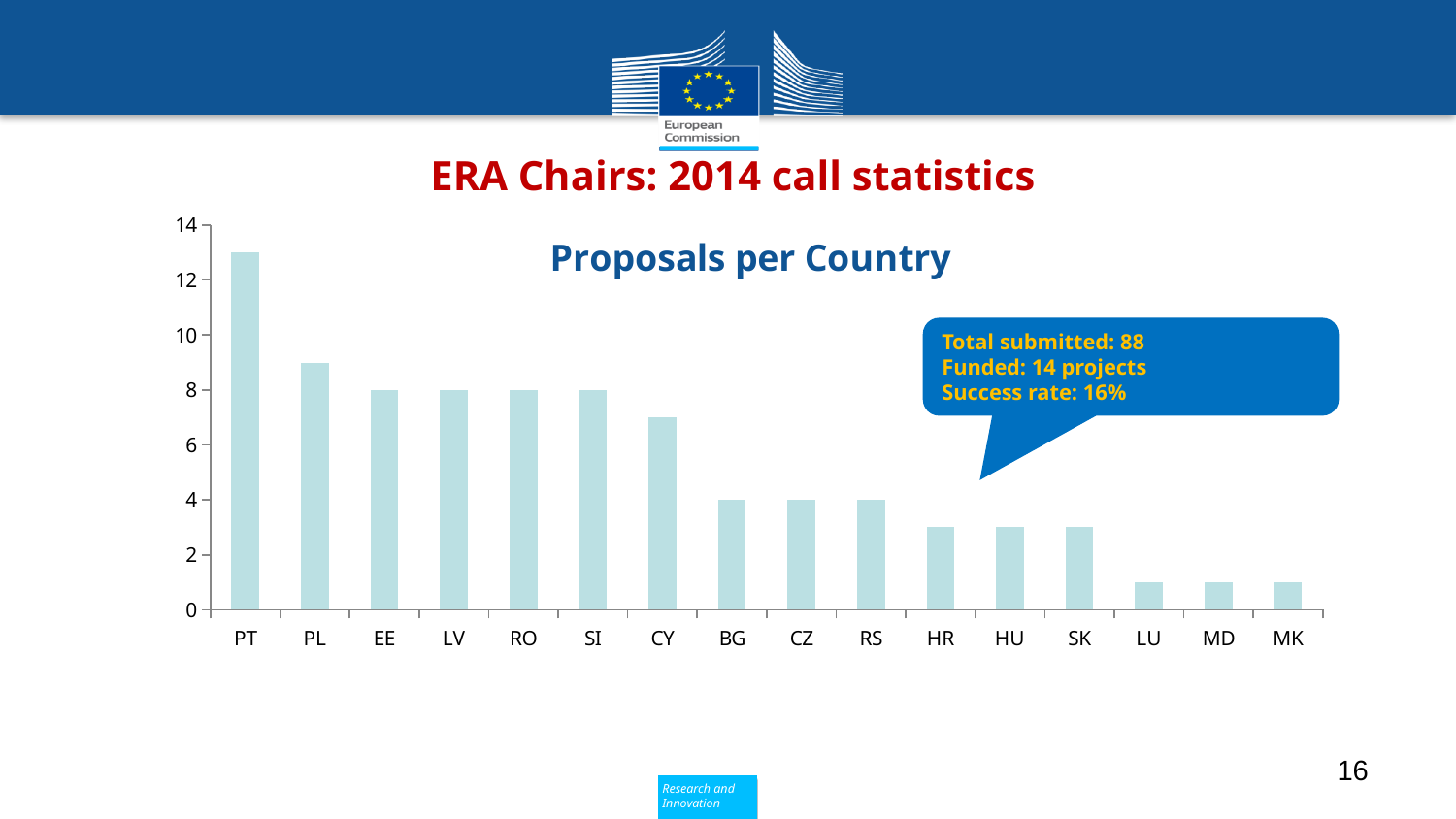
How many proposals does BG have? 4 Do the values rise or fall moving from left to right along the x axis? fall What is the difference between the number of proposals for LV and for CZ? 4 How many countries are shown on the x axis of the chart? 16 Is the value for PT greater or less than 12? greater Is the value for HU greater or less than 4? less What kind of chart is shown on the slide? bar chart How many proposals does RS have? 4 Which country has the highest number of proposals? PT How many proposals does EE have? 8 Which has more proposals, PL or CY? PL What is the title of the chart? Proposals per Country